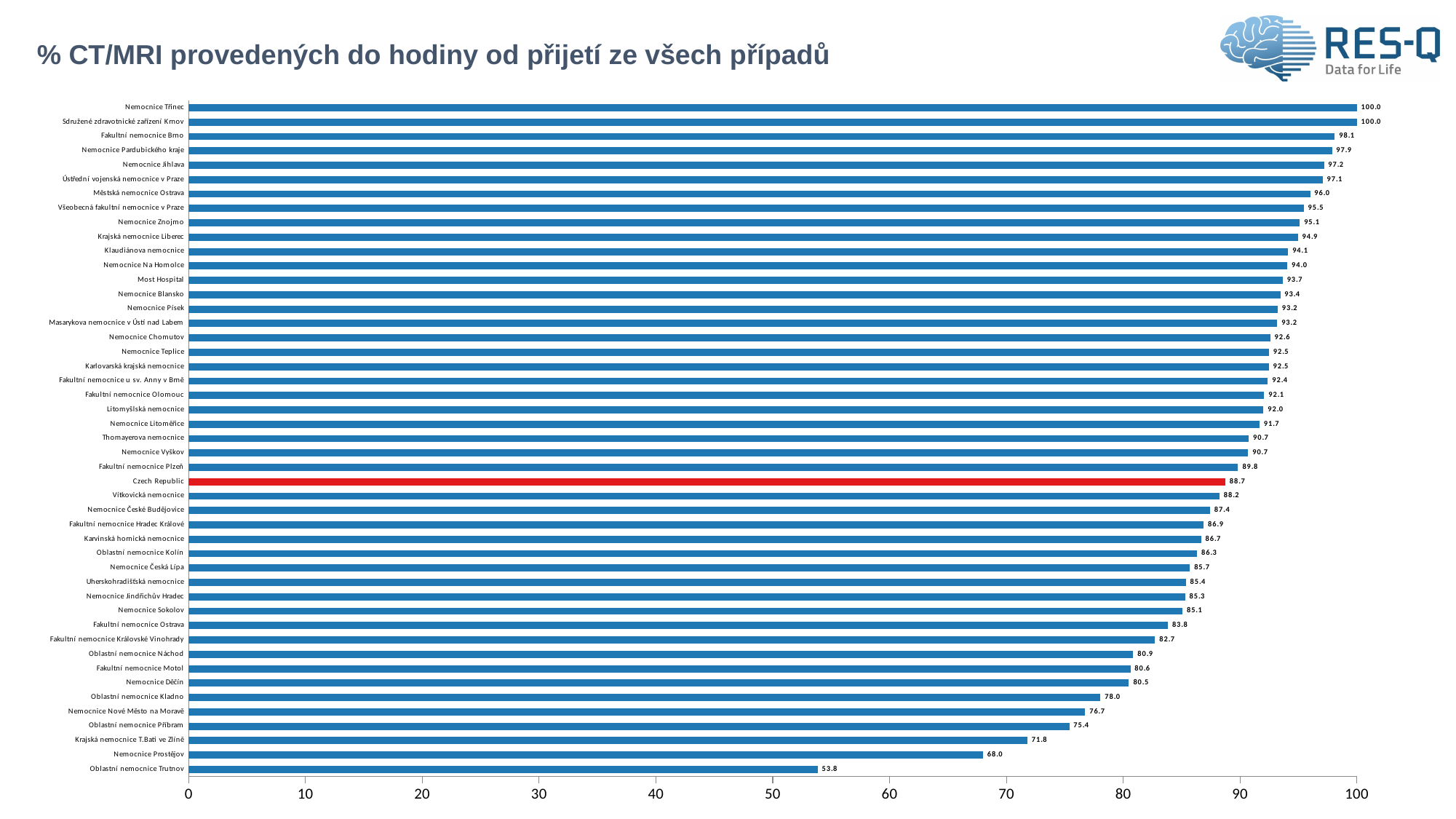
Which category has the lowest value? Oblastní nemocnice Trutnov What is the value for Fakultní nemocnice Brno? 98.1 What is the value for Fakultní nemocnice Motol? 80.6 What is the value for Czech Republic? 88.7 What is the difference between the values for Czech Republic and Oblastní nemocnice Trutnov? 34.9 What is the title of the chart? % CT/MRI provedených do hodiny od přijetí ze všech případů How many bars does the chart have? 47 Is the value for Krajská nemocnice T.Bati ve Zlíně greater or less than 80? less What kind of chart is shown on the slide? bar chart Which bar is coloured red instead of blue? Czech Republic Which is larger, the value for Fakultní nemocnice Plzeň or the value for Fakultní nemocnice Ostrava? Fakultní nemocnice Plzeň What is the value for Nemocnice Prostějov? 68.0